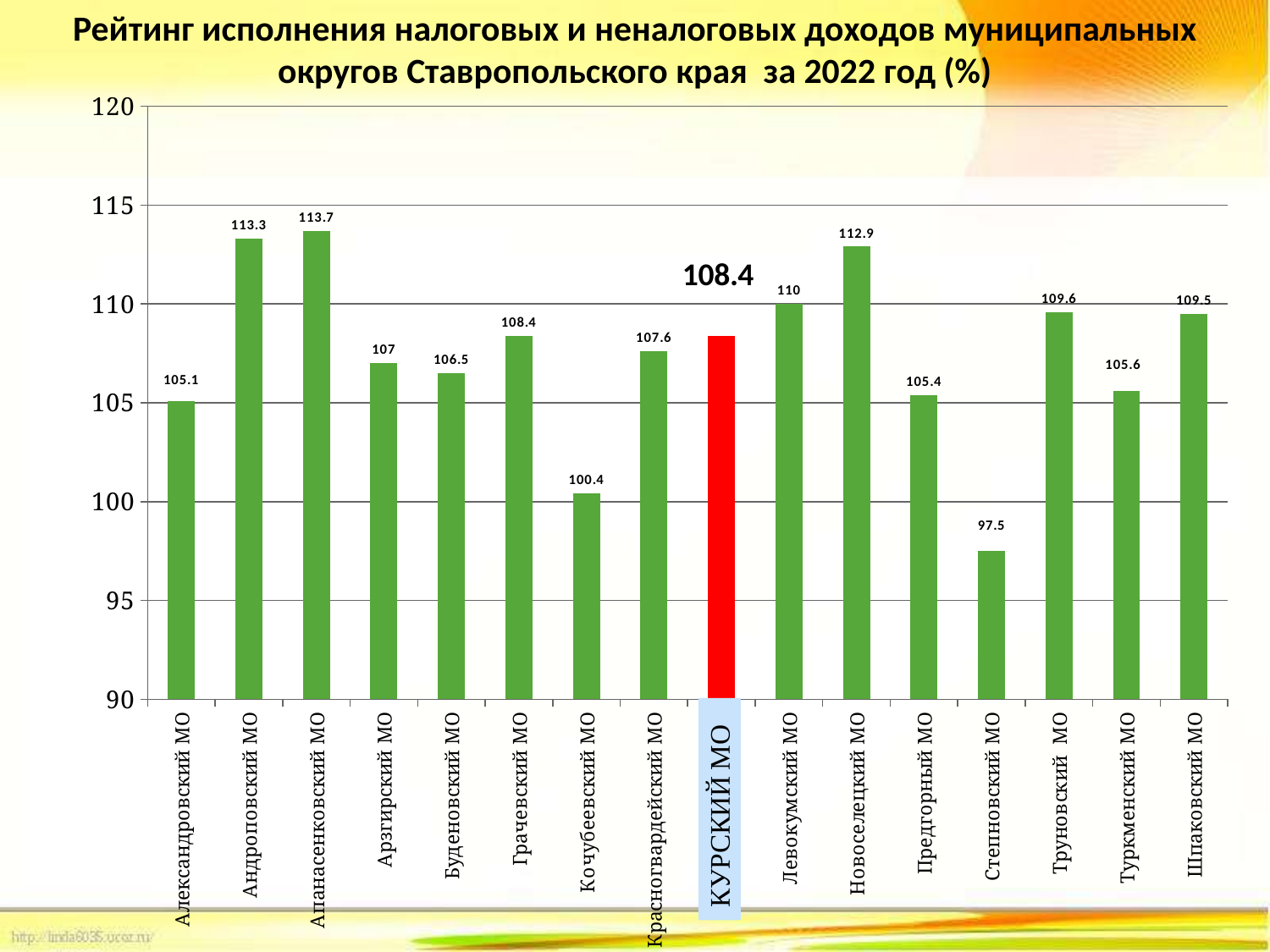
Which municipal district's bar is coloured red? Курский МО What is the difference between the values for Апанасенковский МО and Андроповский МО? 0.4 What type of chart is shown on the slide? Bar chart What value is shown for Кочубеевский МО? 100.4 Which municipal district has the lowest value? Степновский МО What is the difference between the values for Левокумский МО and Курский МО? 1.6 Which municipal district has the highest value? Апанасенковский МО What value is shown for Курский МО? 108.4 How many municipal districts are shown on the chart? 16 Which is larger, the value for Труновский МО or the value for Туркменский МО? Труновский МО What value is shown for Новоселецкий МО? 112.9 What value is shown for Степновский МО? 97.5